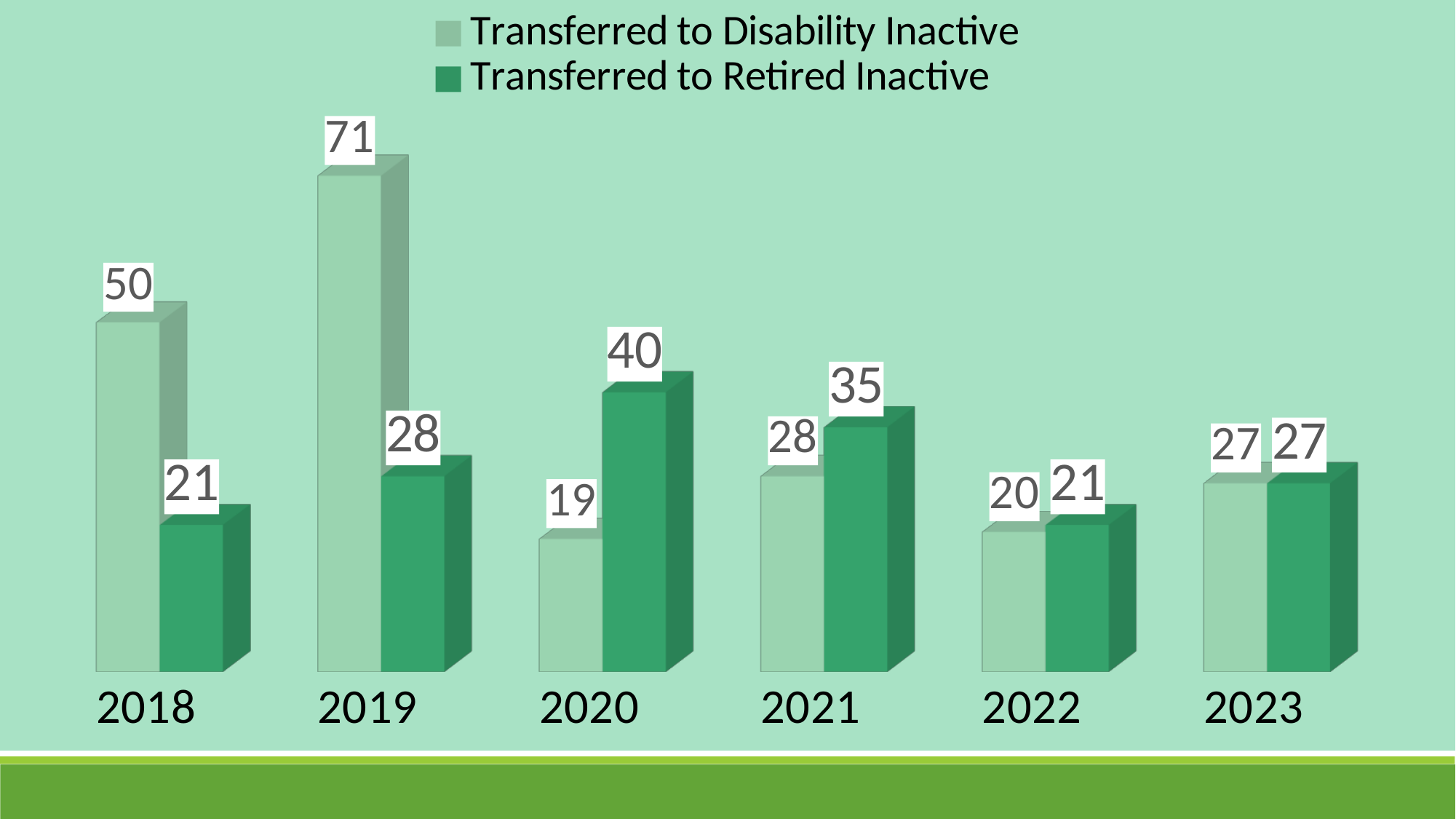
What is the difference between Transferred to Disability Inactive and Transferred to Retired Inactive in 2018? 29 Which year has the lowest value for Transferred to Retired Inactive? 2018 and 2022 (both 21) What is the value for Transferred to Disability Inactive in 2022? 20 How many years are shown on the x axis? 6 What kind of chart is shown on the slide? Bar chart What is the value for Transferred to Retired Inactive in 2020? 40 What is the difference between Transferred to Retired Inactive and Transferred to Disability Inactive in 2020? 21 How many series does the legend list? 2 Which series is shown in the darker green colour? Transferred to Retired Inactive Which year has the highest value for Transferred to Disability Inactive? 2019 What is the value for Transferred to Disability Inactive in 2019? 71 In 2021, which series has the larger value, Transferred to Disability Inactive or Transferred to Retired Inactive? Transferred to Retired Inactive